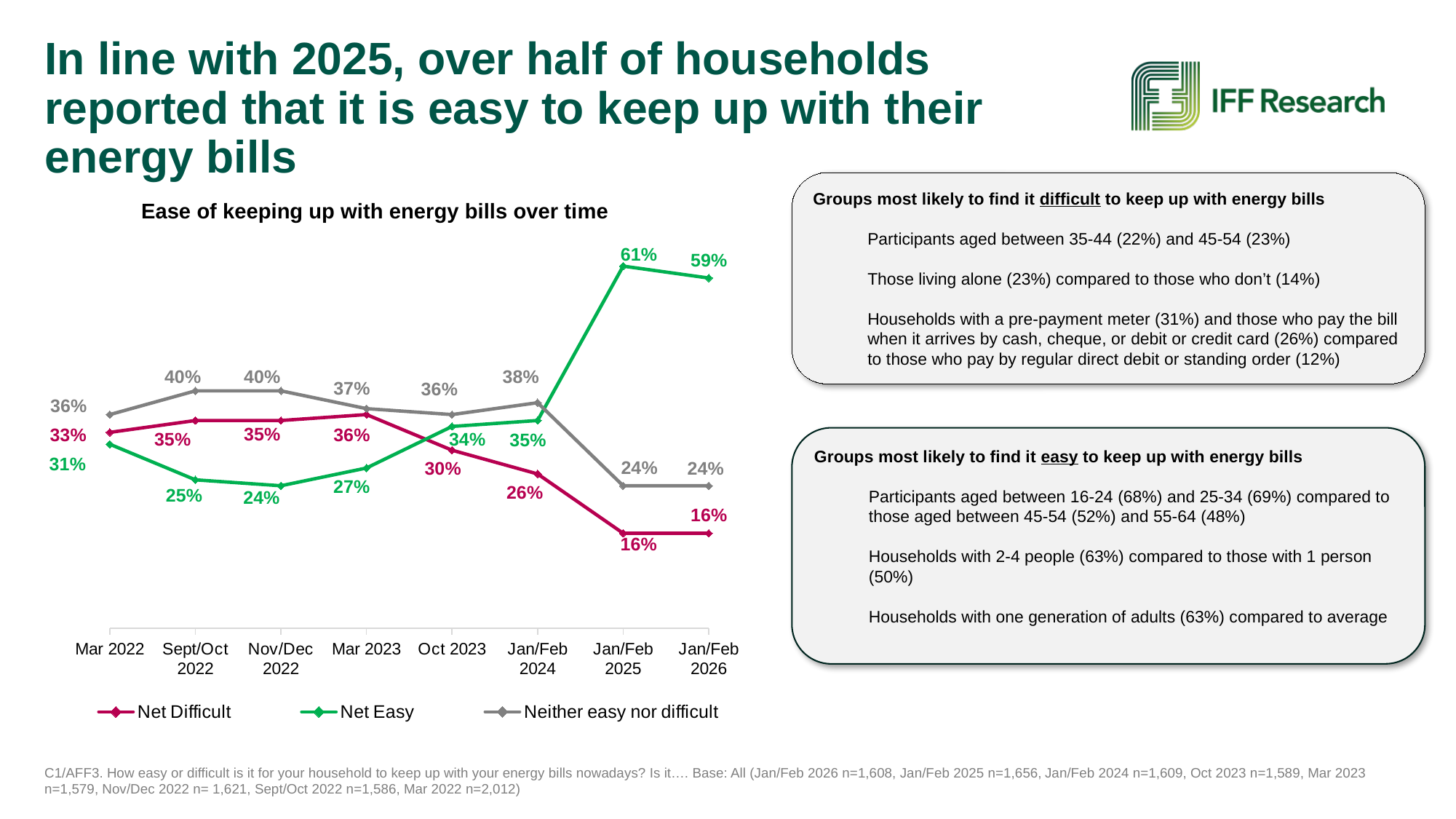
What kind of chart is shown on the slide? Line chart How many series does the legend list? 3 How many time periods are plotted on the x axis? 8 In which period is the Net Easy value lowest? Nov/Dec 2022 In Mar 2022, which is larger: Net Difficult or Net Easy? Net Difficult In which period is the Net Easy value highest? Jan/Feb 2025 What is the Net Easy value for Jan/Feb 2026? 59% What is the difference between the Net Easy and Net Difficult values in Jan/Feb 2026? 43 percentage points What is the Neither easy nor difficult value for Sept/Oct 2022? 40% Does the Net Difficult value rise or fall from Mar 2023 to Jan/Feb 2025? Fall What is the Net Difficult value for Oct 2023? 30% What colour is the Net Easy line in the chart? Green